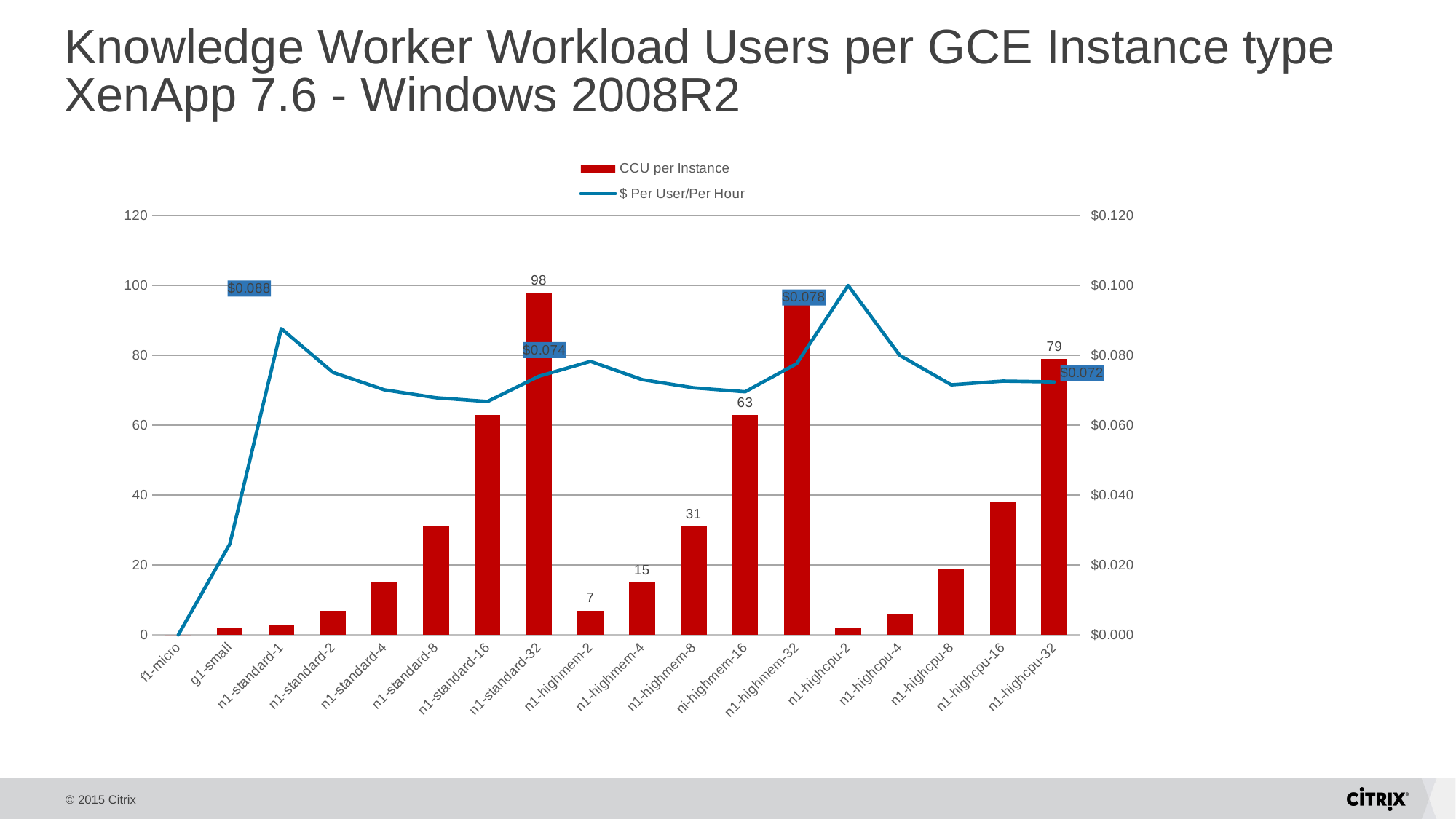
What is the CCU per Instance value for n1-standard-32? 98 What is the CCU per Instance value for n1-highcpu-32? 79 Is the CCU per Instance value for n1-standard-16 greater or less than 60? greater What is the CCU per Instance value for ni-highmem-16? 63 How many instance types are shown on the x axis? 18 Which has a higher CCU per Instance, n1-highmem-8 or n1-highcpu-32? n1-highcpu-32 What is the difference in CCU per Instance between n1-standard-32 and n1-highcpu-32? 19 Which instance type has the highest CCU per Instance? n1-standard-32 and n1-highmem-32 (tied at 98) What kind of chart is shown on the slide? bar and line chart Which instance type has the lowest CCU per Instance? f1-micro What is the $ Per User/Per Hour value labelled at n1-highmem-32? $0.078 How many series does the legend list? 2